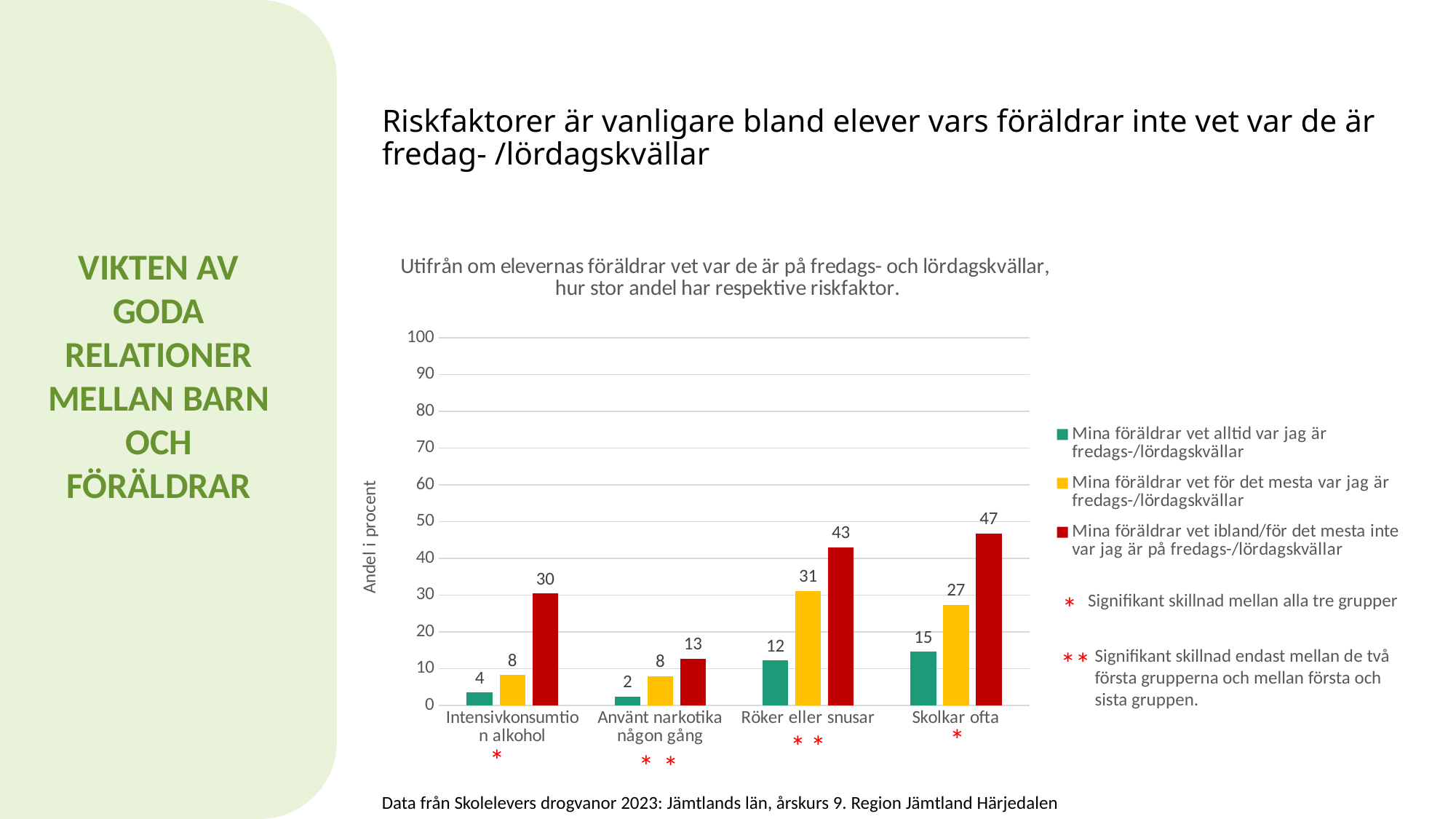
What is the value for 'Röker eller snusar' in the series 'Mina föräldrar vet för det mesta var jag är fredags-/lördagskvällar'? 31 Is the value for 'Skolkar ofta' in the series 'Mina föräldrar vet ibland/för det mesta inte var jag är' greater or less than 40? greater What is the value for 'Skolkar ofta' in the series 'Mina föräldrar vet ibland/för det mesta inte var jag är på fredags-/lördagskvällar'? 47 What is the difference between the 'Mina föräldrar vet ibland/för det mesta inte' value and the 'Mina föräldrar vet alltid' value for 'Intensivkonsumtion alkohol'? 26 For 'Röker eller snusar', which is larger: the value for 'Mina föräldrar vet alltid var jag är' or the value for 'Mina föräldrar vet för det mesta var jag är'? Mina föräldrar vet för det mesta var jag är fredags-/lördagskvällar Which category has the lowest value in the series 'Mina föräldrar vet alltid var jag är fredags-/lördagskvällar'? Använt narkotika någon gång What is the value for 'Använt narkotika någon gång' in the series 'Mina föräldrar vet alltid var jag är fredags-/lördagskvällar'? 2 What kind of chart is shown on the slide? bar chart How many series does the legend list? 3 What is the label of the y axis? Andel i procent How many categories are shown on the x axis? 4 Which category has the highest value in the series 'Mina föräldrar vet ibland/för det mesta inte var jag är på fredags-/lördagskvällar'? Skolkar ofta